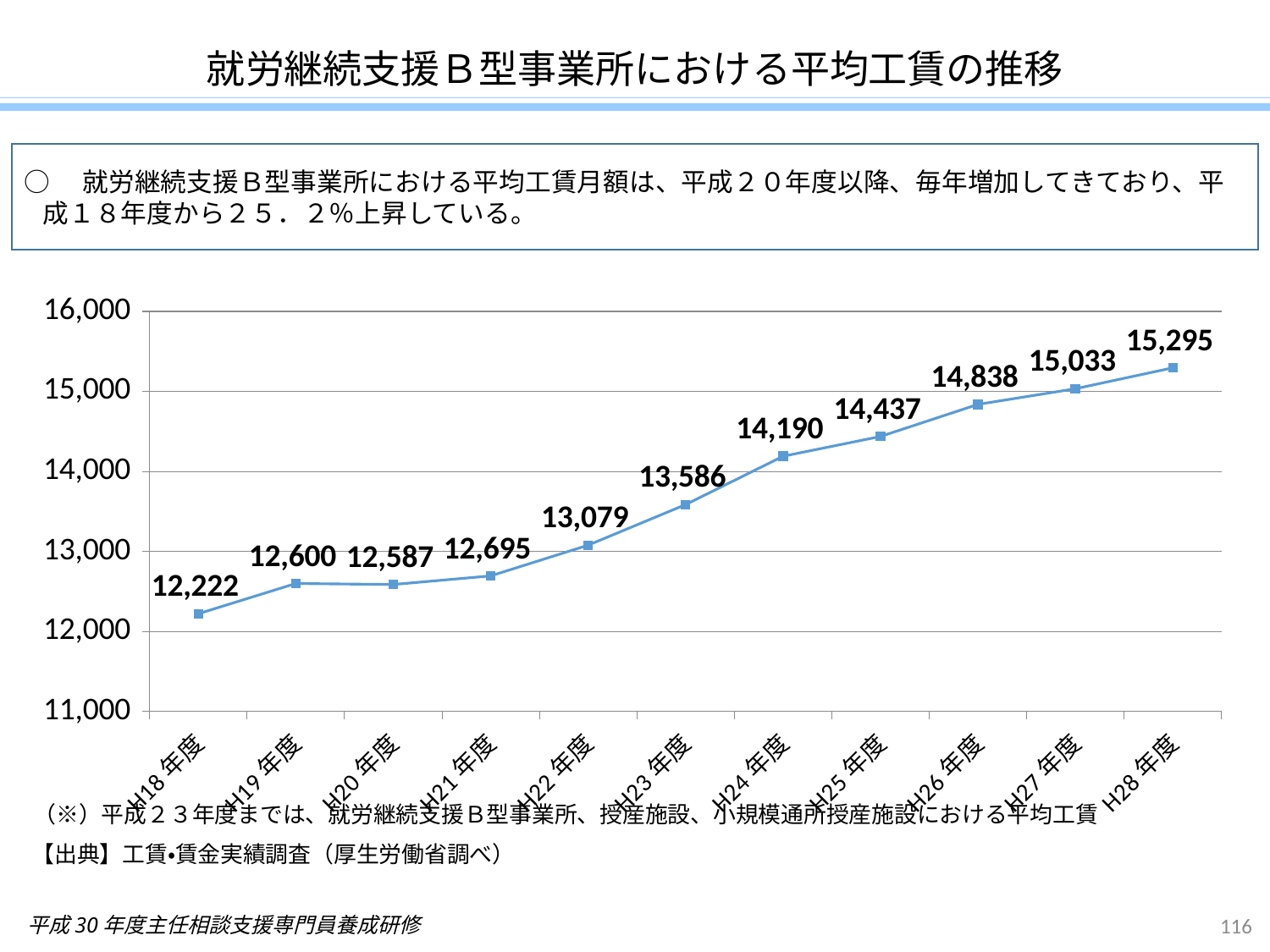
What is the value plotted for H28年度? 15,295 Do the values generally rise or fall from H18年度 to H28年度? rise Which is larger, the value for H26年度 or the value for H25年度? H26年度 Is the value for H22年度 greater or less than 13,000? greater Which fiscal year has the lowest value on the chart? H18年度 Which fiscal year has the highest value on the chart? H28年度 What is the difference between the values for H28年度 and H18年度? 3,073 What kind of chart is shown on the slide? line chart What is the average wage value for H18年度? 12,222 What is the value plotted for H24年度? 14,190 How many fiscal years are plotted on the chart? 11 What is the difference between the values for H24年度 and H23年度? 604